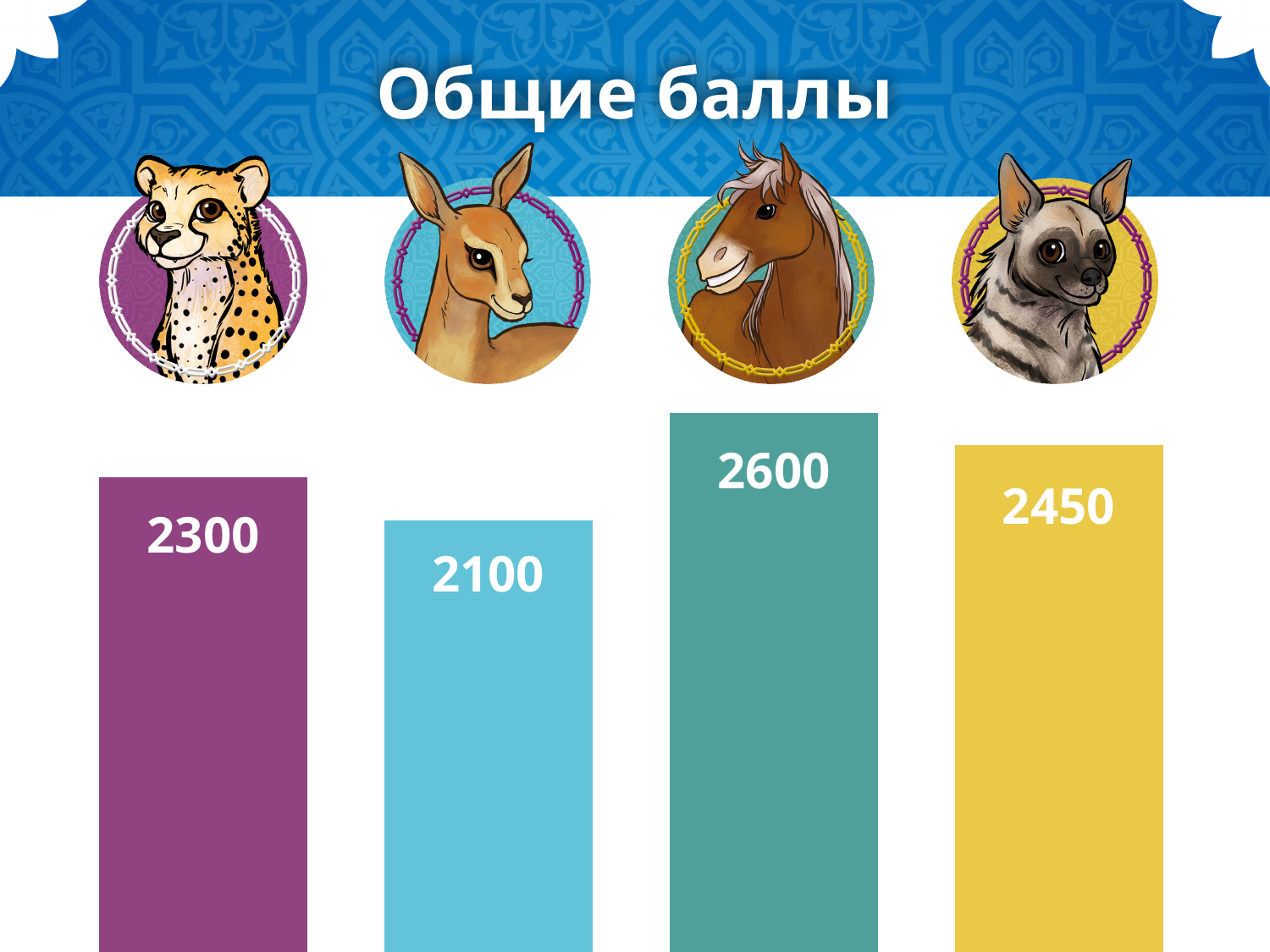
Which animal has the highest total score? The horse (2600) What is the value of the second (light blue) bar, under the gazelle? 2100 What type of chart is shown on the slide? Bar chart Which is larger, the cheetah's score or the hyena's score? The hyena's score (2450) What is the value of the third (teal) bar, under the horse? 2600 How many bars are shown in the chart? 4 Which animal has the lowest total score? The gazelle (2100) What is the title of the chart? Общие баллы What is the difference between the horse's score and the gazelle's score? 500 What is the value of the first (leftmost, purple) bar, under the cheetah? 2300 What is the value of the fourth (yellow) bar, under the hyena? 2450 What is the difference between the hyena's score and the cheetah's score? 150